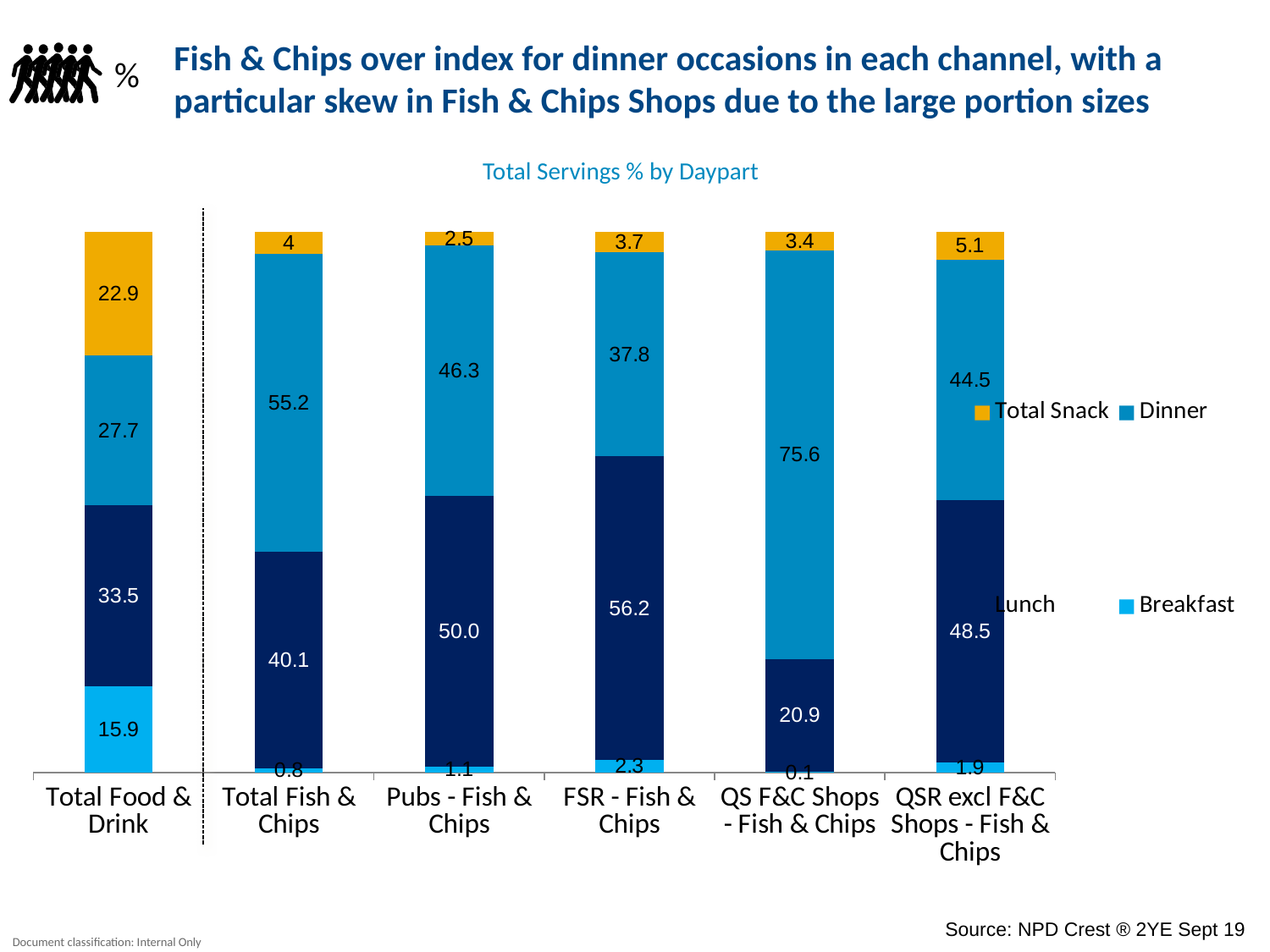
What is the Lunch value for FSR - Fish & Chips? 56.2 What is the title of the chart? Total Servings % by Daypart Which is larger, the Lunch value for Pubs - Fish & Chips or the Lunch value for Total Fish & Chips? Pubs - Fish & Chips What is the Dinner value for QS F&C Shops - Fish & Chips? 75.6 How many categories are shown on the x axis? 6 What is the Total Snack value for QSR excl F&C Shops - Fish & Chips? 5.1 Which category has the lowest Breakfast value? QS F&C Shops - Fish & Chips What kind of chart is shown on the slide? Stacked bar chart What is the Breakfast value for Total Food & Drink? 15.9 Which category has the highest Dinner value? QS F&C Shops - Fish & Chips How many series does the legend list? 4 What is the difference between the Dinner values for Total Fish & Chips and Total Food & Drink? 27.5